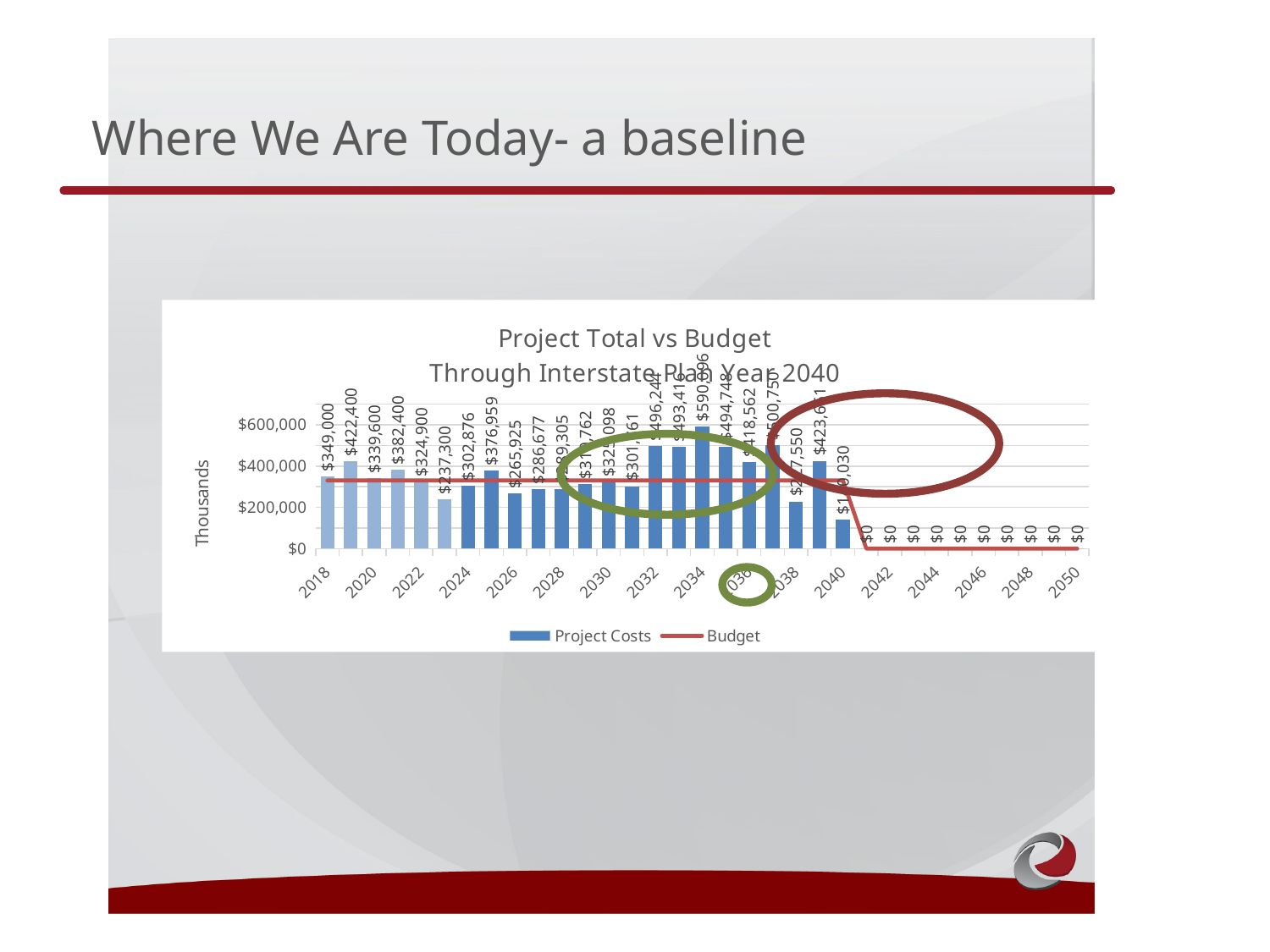
What is the title of the chart? Project Total vs Budget Through Interstate Plan Year 2040 What is the difference between the Project Costs for 2019 and 2018? $73,400 How many series does the legend list? 2 Is the Project Costs value for 2034 greater or less than $400,000? greater Which year has higher Project Costs, 2023 or 2038? 2023 What is the Project Costs value for 2018? $349,000 What type of chart is shown on the slide? bar chart (with a line series) Is the Budget line for 2030 greater or less than $400,000? less Which year has the highest Project Costs bar? 2034 What is the Project Costs value for 2038? $227,550 What is the Project Costs value for 2025? $376,959 Among the years 2018 through 2040, which year has the lowest Project Costs bar? 2040